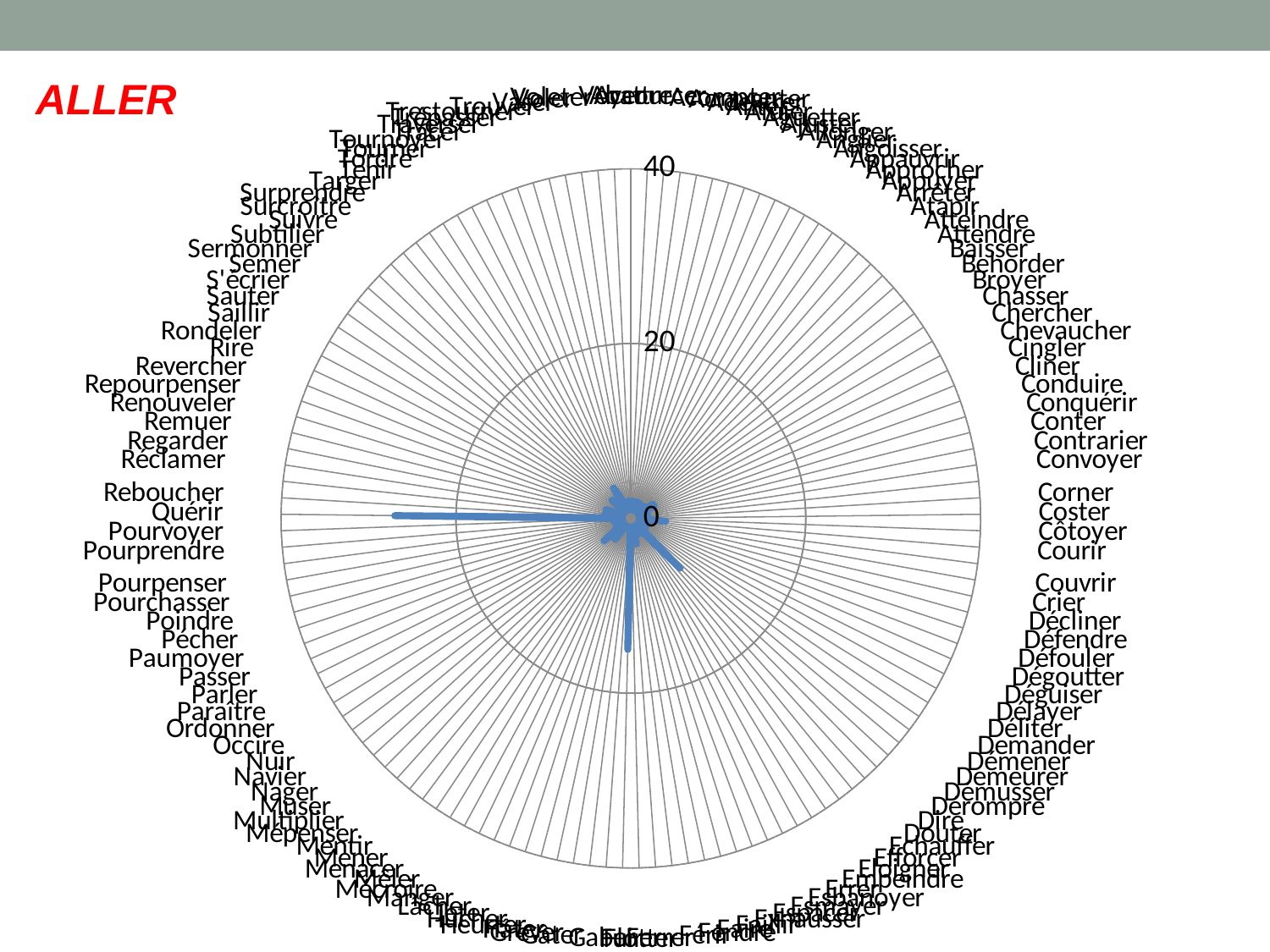
Is the value for Quérir greater or less than 20? greater Is the largest value plotted on the chart greater or less than 40? less Which is larger, the value for Quérir or the value for Conduire? Quérir What kind of chart is shown on the slide? radar chart Is the value for Courir greater or less than 20? less What colour is the plotted data series on the chart? blue What is the highest value shown on the chart's radial axis? 40 What is the title of the chart on the slide? ALLER